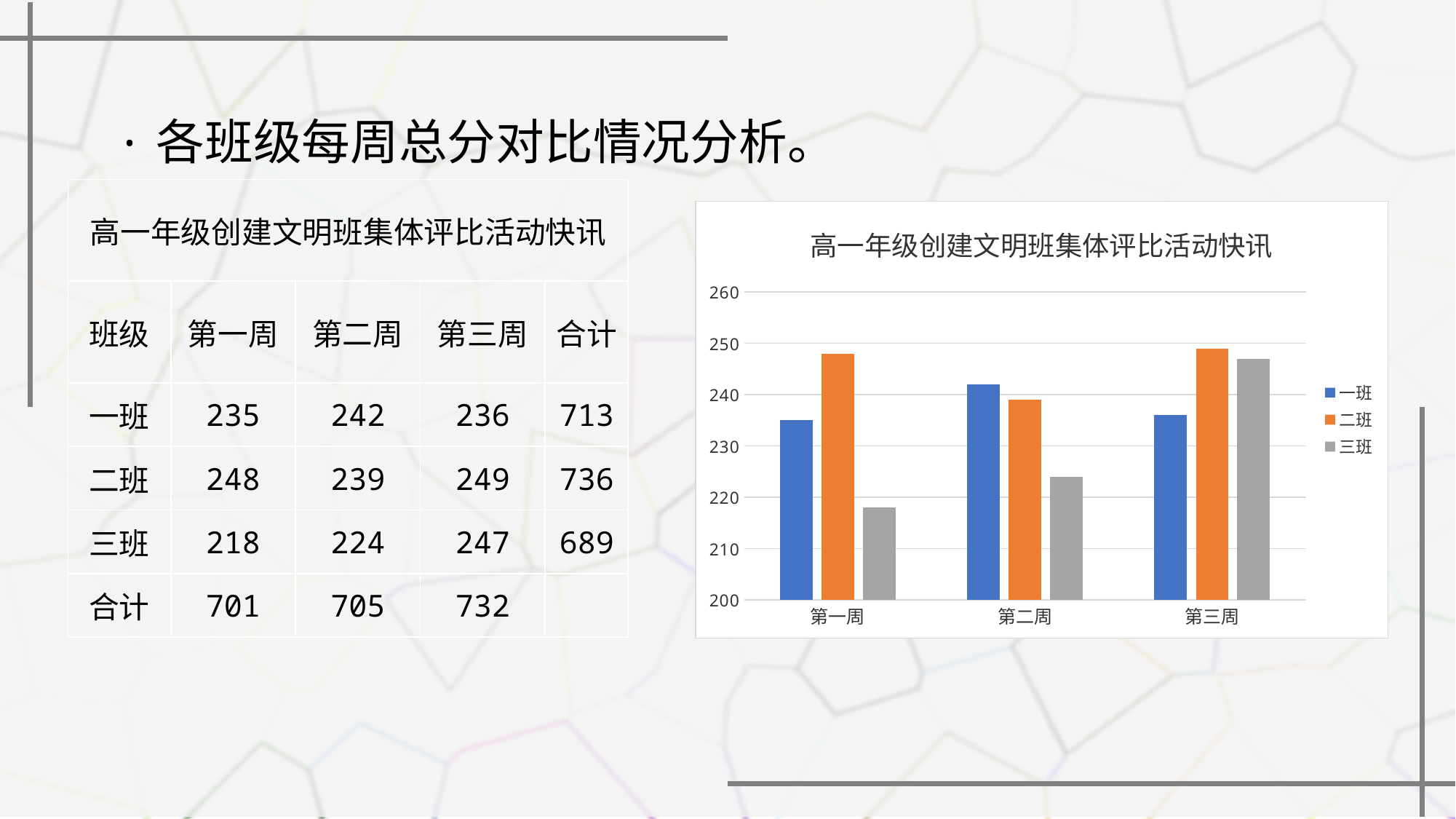
What is the value for 三班 in 第三周? 247 How many series does the chart legend list? 3 Which is larger, 一班 in 第二周 or 二班 in 第二周? 一班 in 第二周 What is the value for 二班 in 第一周? 248 What kind of chart is shown on the slide? bar chart Is the value for 二班 in 第三周 greater or less than 240? greater Is the value for 三班 in 第一周 greater or less than 220? less What is the difference between 二班 and 三班 in 第一周? 30 How many categories are shown on the x axis of the chart? 3 Do the values for 三班 rise or fall from 第一周 to 第三周? rise Which class has the lowest value in 第一周? 三班 Which class has the highest value in 第二周? 一班